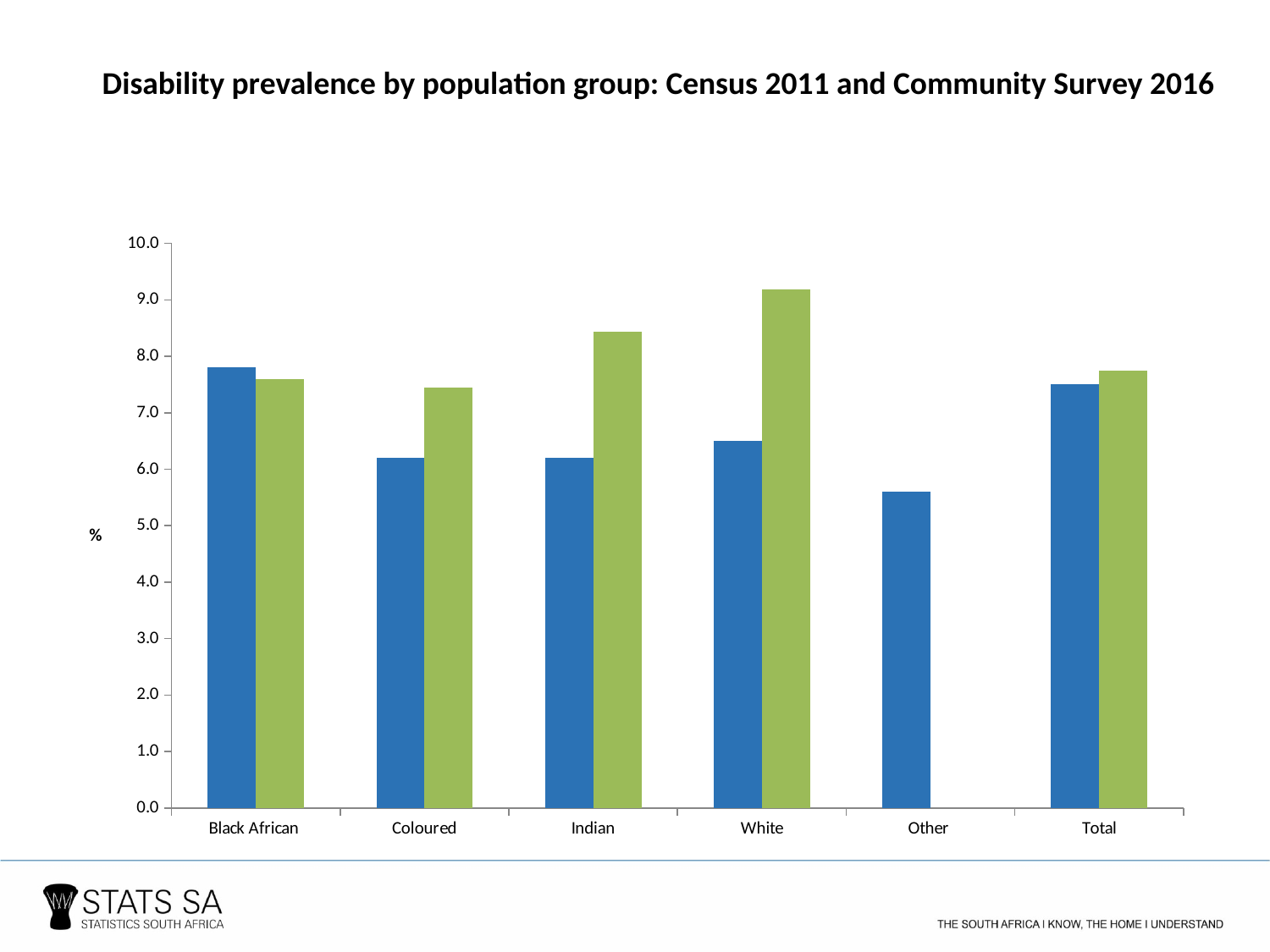
Is the green bar for Indian greater or less than 8.0? greater What kind of chart is shown on the slide? bar chart Is the blue bar for Coloured greater or less than 7.0? less What is the title of the chart? Disability prevalence by population group: Census 2011 and Community Survey 2016 Which category has the tallest green bar? White Is the blue bar for Other greater or less than 6.0? less Which category has only a blue bar and no green bar? Other How many population group categories are shown on the x axis? 6 For Indian, which bar is taller, the blue bar or the green bar? green bar Which category has the shortest blue bar? Other Which category has the tallest blue bar? Black African